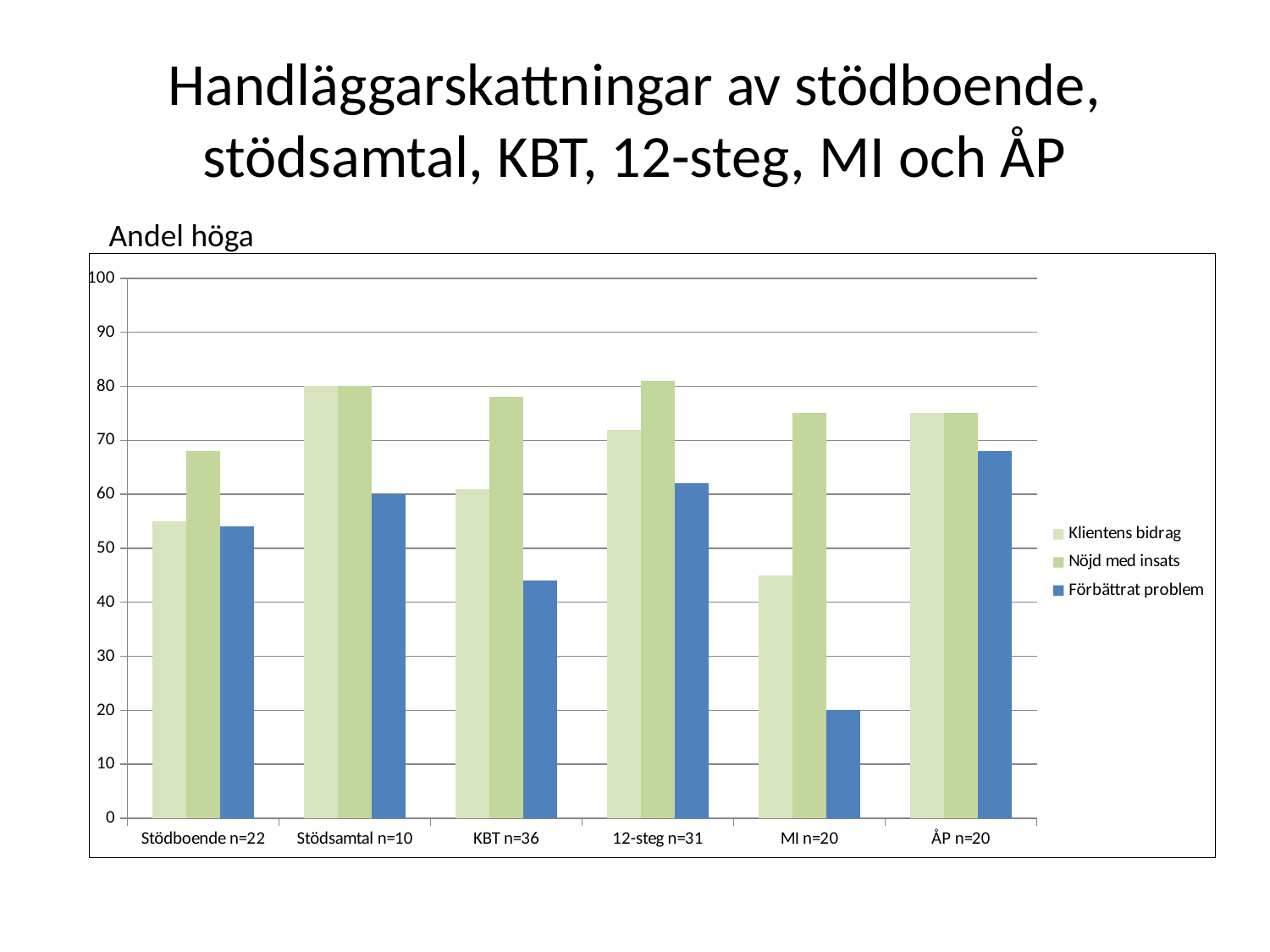
What is the value of Klientens bidrag for Stödsamtal n=10? 80 Which category has the lowest value for Klientens bidrag? MI n=20 How many series does the legend list? 3 Which category has the lowest value for Förbättrat problem? MI n=20 Which is larger: Förbättrat problem for Stödsamtal n=10 or for KBT n=36? Stödsamtal n=10 What is the value of Förbättrat problem for Stödsamtal n=10? 60 Is the value of Nöjd med insats for Stödboende n=22 greater or less than 60? greater Which category has the highest value for Förbättrat problem? ÅP n=20 Is the value of Förbättrat problem for KBT n=36 greater or less than 50? less What kind of chart is shown on the slide? bar chart How many categories are shown on the x axis? 6 What is the value of Förbättrat problem for MI n=20? 20